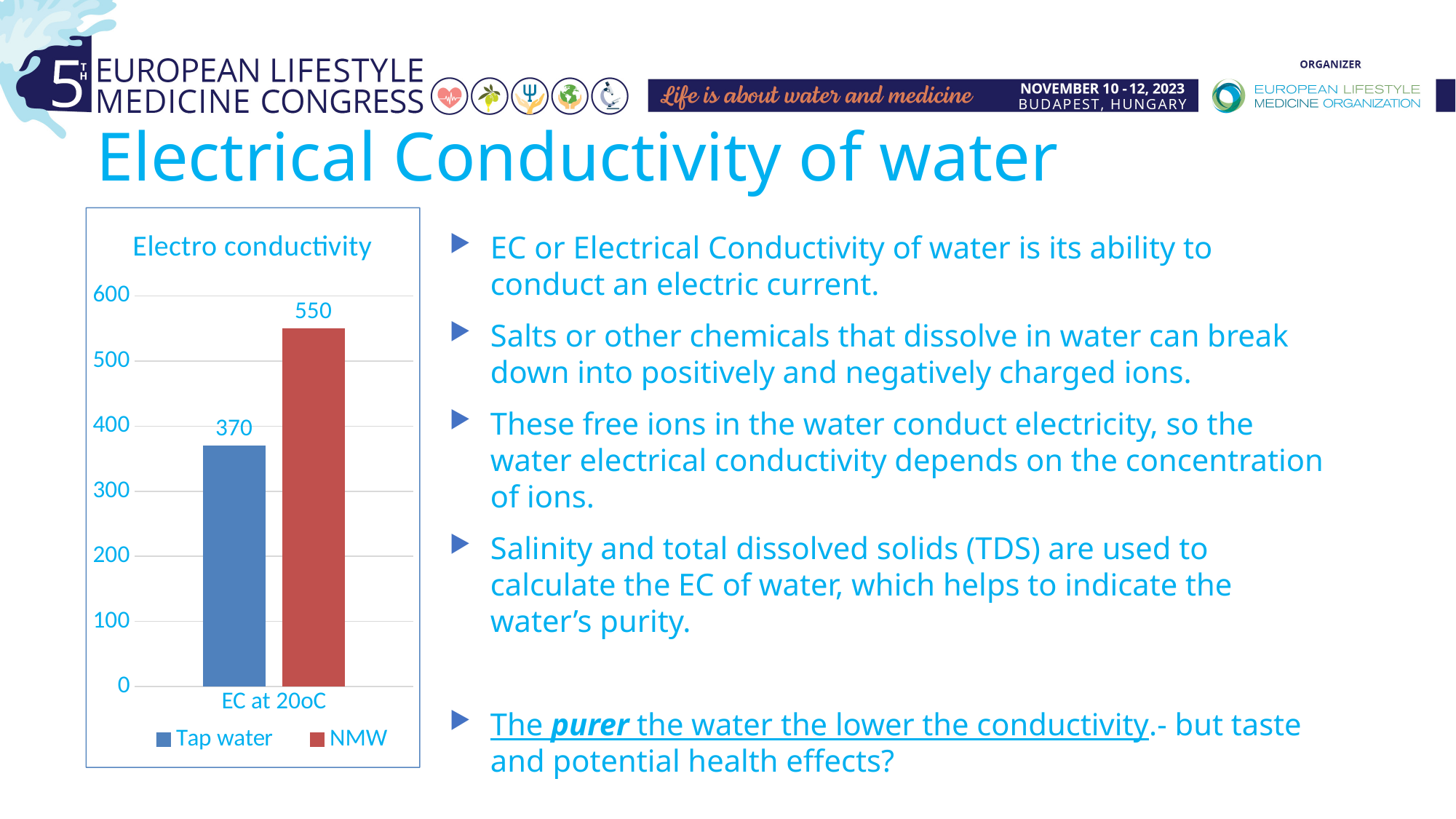
What kind of chart is the Electro conductivity chart? bar chart Is the value for NMW greater or less than 500? greater What is the value for NMW in the Electro conductivity chart? 550 How many series does the legend of the Electro conductivity chart list? 2 Is the value for Tap water greater or less than 400? less Is the value for Tap water larger or smaller than the value for NMW? smaller What is the category label on the x axis of the Electro conductivity chart? EC at 20oC What is the difference between the NMW and Tap water values in the Electro conductivity chart? 180 Which series has the higher value in the Electro conductivity chart? NMW Which series has the lower value in the Electro conductivity chart? Tap water What is the value for Tap water in the Electro conductivity chart? 370 What is the title of the chart on the slide? Electro conductivity